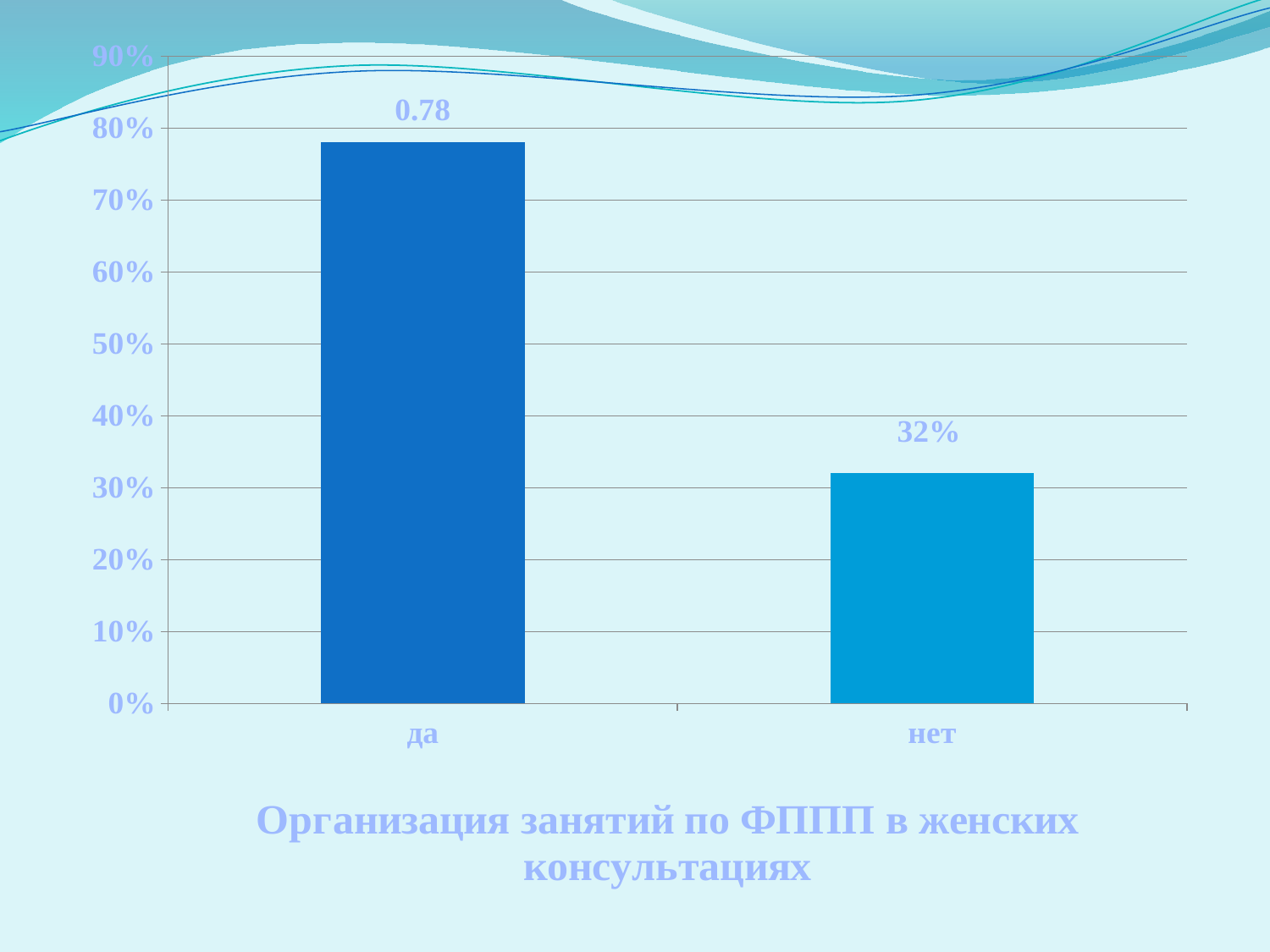
What kind of chart is shown on the slide? bar chart What value is shown for the "да" bar? 0.78 Which bar is taller, "да" or "нет"? да Which category has the lowest bar? нет Which category has the highest bar? да Is the value for "да" greater or less than 70%? greater How many categories are shown on the x axis? 2 What is the title of the chart? Организация занятий по ФППП в женских консультациях Is the value for "нет" greater or less than 40%? less What is the highest value labelled on the vertical axis? 90% What value is shown for the "нет" bar? 32% Do the bar values rise or fall from left to right along the x axis? fall